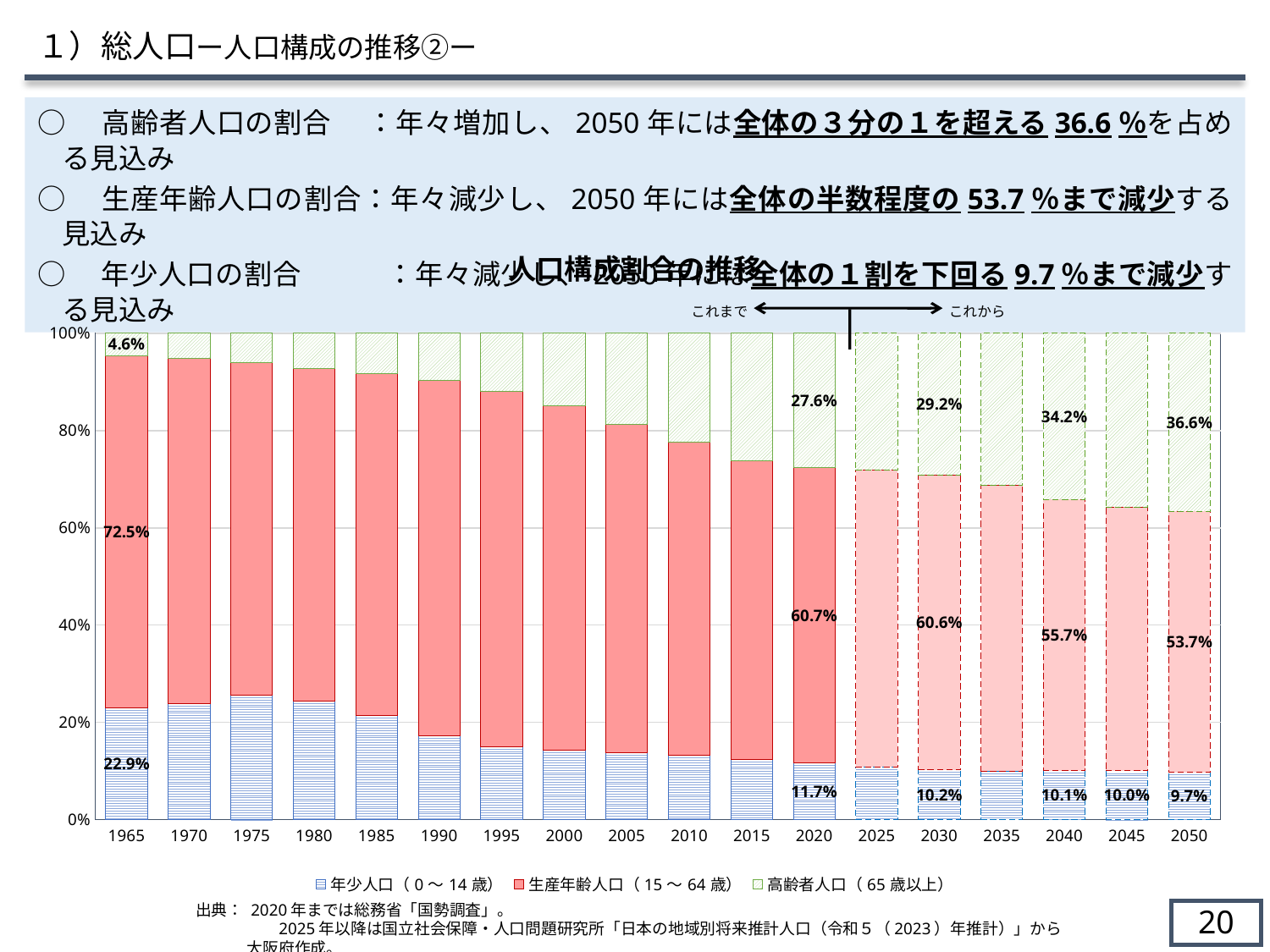
What kind of chart is shown on the slide? Stacked bar chart How many years are shown on the x axis of the chart? 18 What is the difference between the 生産年齢人口（15～64歳） share in 2020 and in 2050? 7.0 percentage points Is the value for 年少人口（0～14歳） in 1975 greater or less than 20%? greater What is the difference between the 高齢者人口（65歳以上） share in 2050 and in 1965? 32.0 percentage points What is the value for 高齢者人口（65歳以上） in 2050? 36.6% What is the value for 生産年齢人口（15～64歳） in 1965? 72.5% Does the share of 高齢者人口（65歳以上） rise or fall from 1965 to 2050? Rises What is the value for 年少人口（0～14歳） in 2030? 10.2% Which year has the larger 高齢者人口（65歳以上） share, 2020 or 2040? 2040 How many series does the chart's legend list? 3 What is the value for 年少人口（0～14歳） in 2020? 11.7%